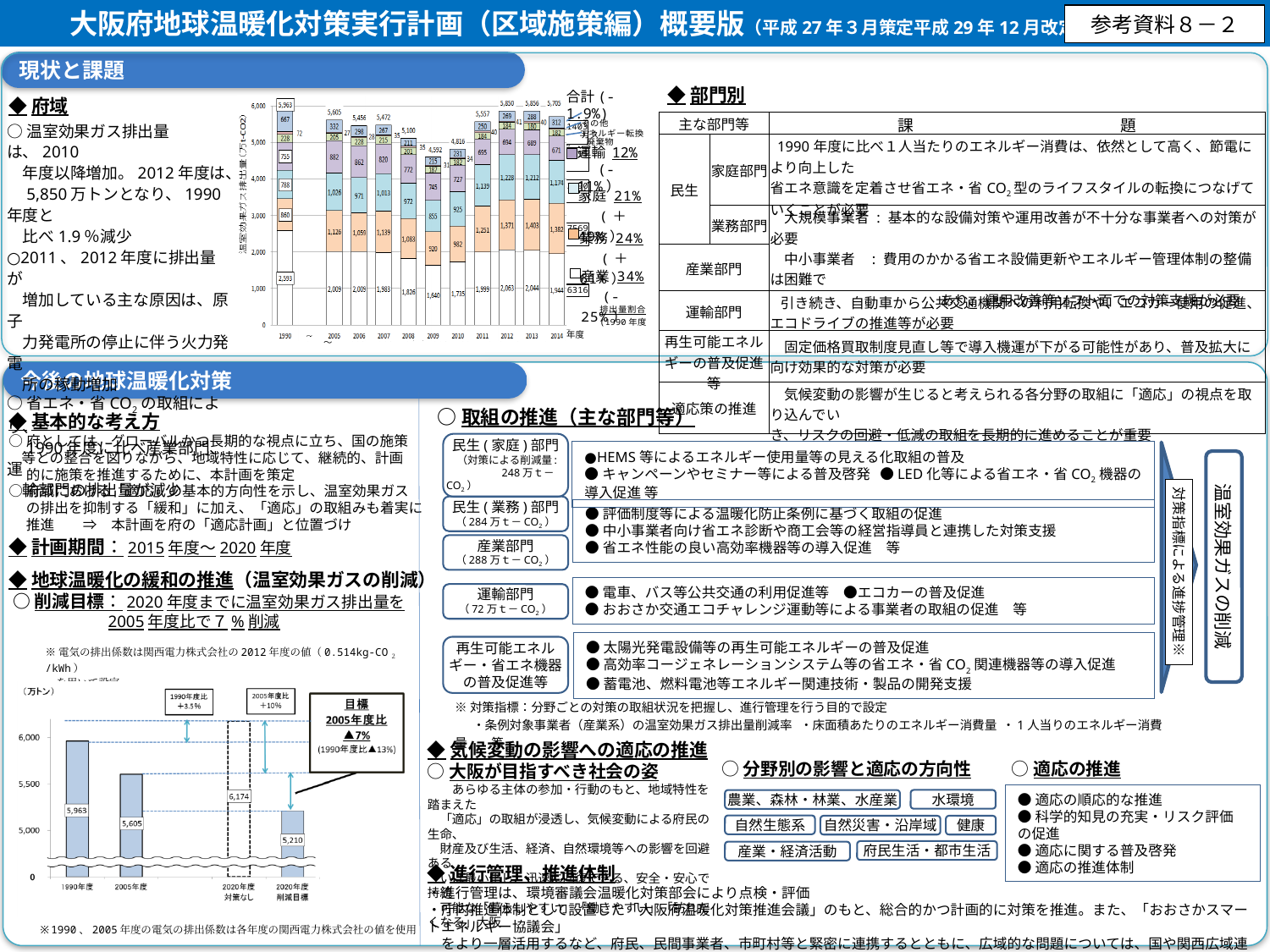
In the stacked bar chart at the top of the slide, what is the total emissions value labeled for 1990? 5,963 In the bar chart at the bottom left of the slide, what is the value shown for 2020年度 削減目標? 5,210 In the bar chart at the bottom left of the slide, which category has the lowest value? 2020年度 削減目標 In the stacked bar chart at the top of the slide, what is the total emissions value labeled for 2012? 5,850 In the stacked bar chart at the top of the slide, what is the value of the bottom (産業) segment for 1990? 2,593 In the bar chart at the bottom left of the slide, what is the difference between the 1990年度 value and the 2005年度 value? 358 In the bar chart at the bottom left of the slide, what is the value shown for 1990年度? 5,963 How many bars are plotted in the bar chart at the bottom left of the slide? 4 What kind of chart is the chart at the bottom left of the slide? bar chart In the bar chart at the bottom left of the slide, which category has the highest value? 2020年度 対策なし In the stacked bar chart at the top of the slide, which year has the lowest total emissions? 2009 In the stacked bar chart at the top of the slide, which year has the larger total, 2012 or 2014? 2012